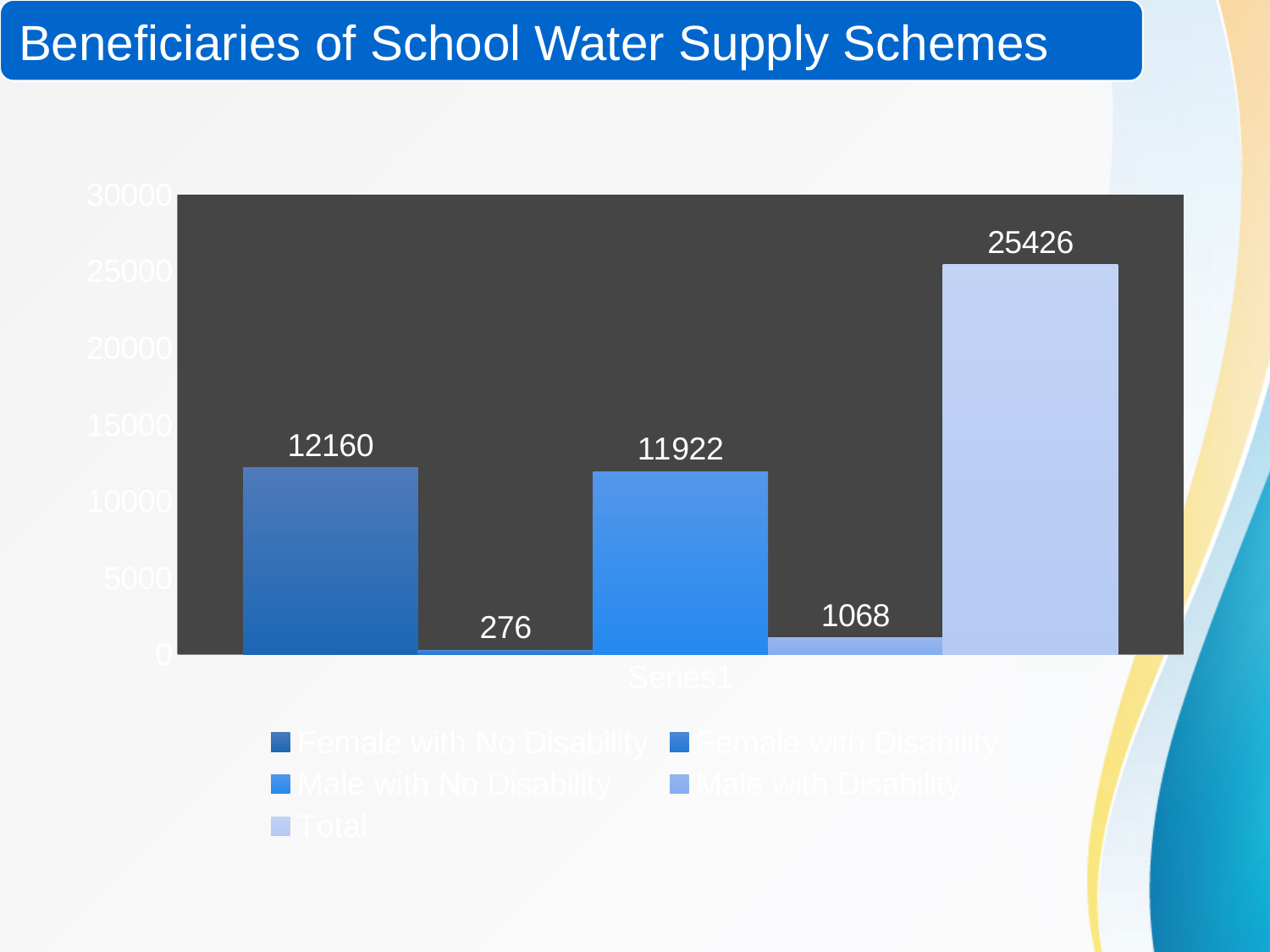
Which series has the lowest value? Female with Disability What kind of chart is shown on the slide? Bar chart What is the value for Female with No Disability? 12160 Which is larger, Male with Disability or Female with Disability? Male with Disability How many series does the legend list? 5 What is the difference between Female with No Disability and Male with No Disability? 238 What is the title of the chart? Beneficiaries of School Water Supply Schemes What is the value for Total? 25426 What is the value for Female with Disability? 276 What is the value for Male with No Disability? 11922 Which series has the highest value? Total What is the value for Male with Disability? 1068